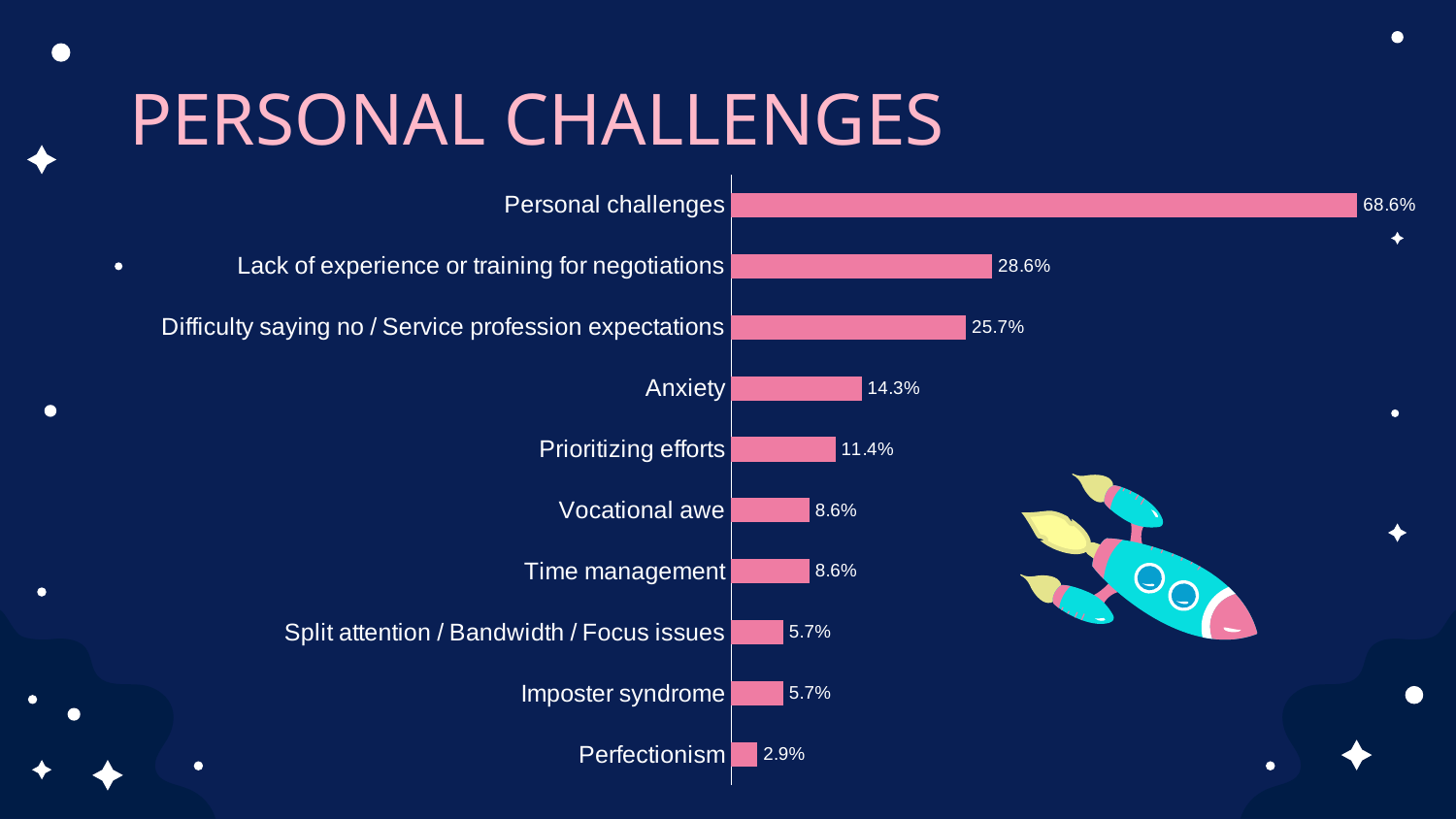
Which category has the lowest value? Perfectionism What kind of chart is shown on the slide? Bar chart Which category has the highest value? Personal challenges What is the difference between the values for Anxiety and Prioritizing efforts? 2.9% What is the value for Lack of experience or training for negotiations? 28.6% What is the title of the slide? PERSONAL CHALLENGES What is the value for Anxiety? 14.3% Which is larger, the value for Difficulty saying no / Service profession expectations or the value for Anxiety? Difficulty saying no / Service profession expectations What is the value for Imposter syndrome? 5.7% What is the value for Perfectionism? 2.9% How many categories are shown in the chart? 10 What is the difference between the values for Personal challenges and Lack of experience or training for negotiations? 40%